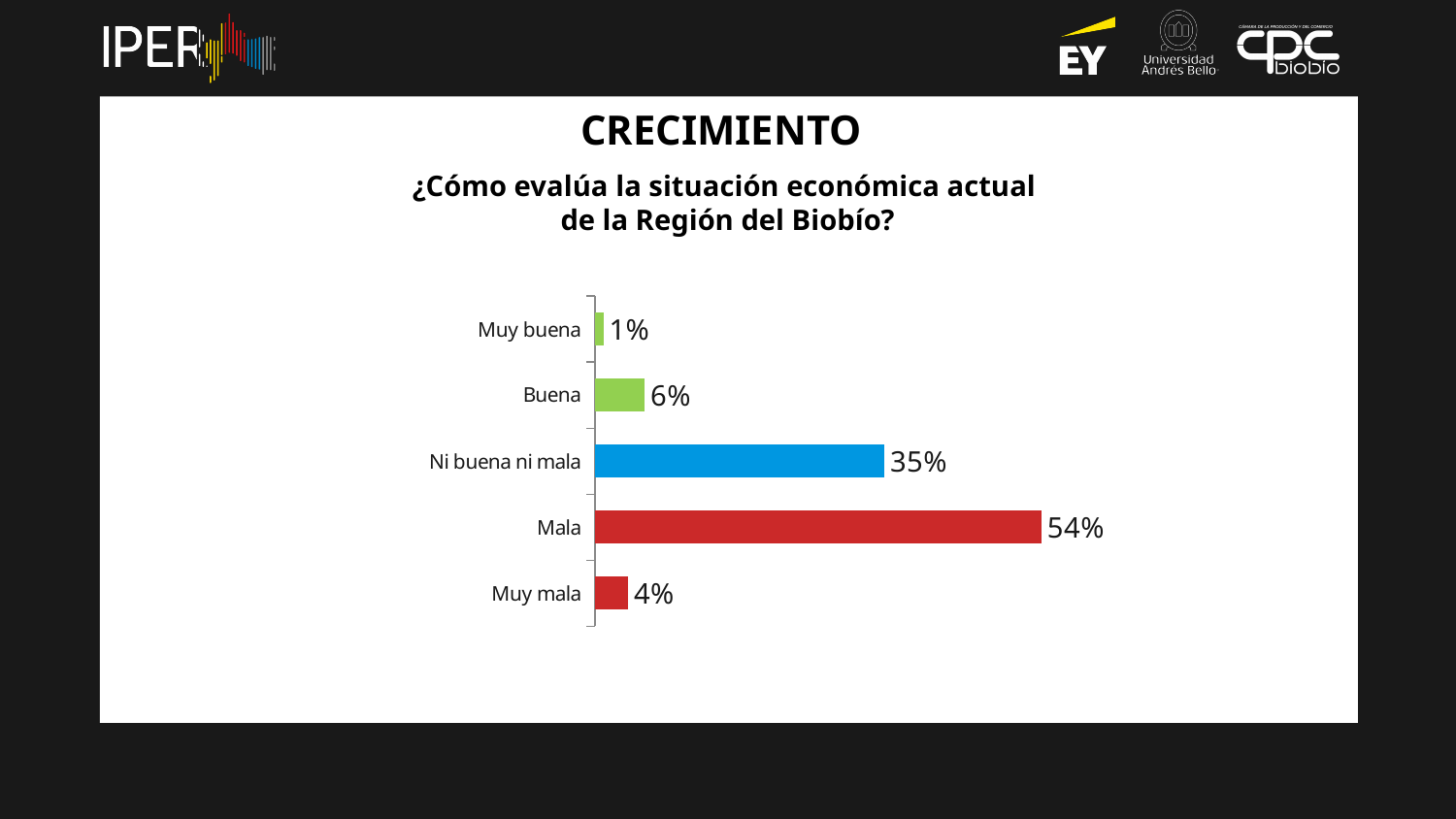
What colour is the bar for "Ni buena ni mala"? Blue Which is larger, the value for "Buena" or the value for "Muy mala"? Buena What is the value shown for "Ni buena ni mala"? 35% What is the combined value of "Muy buena" and "Buena"? 7% What is the difference between the values for "Mala" and "Ni buena ni mala"? 19% What kind of chart is shown on the slide? Bar chart How many categories are shown in the chart? 5 Which category has the highest value? Mala What is the value for "Buena"? 6% Which category has the lowest value? Muy buena What percentage of respondents rated the current economic situation of the Biobío Region as "Mala"? 54% What percentage is shown for "Muy buena"? 1%